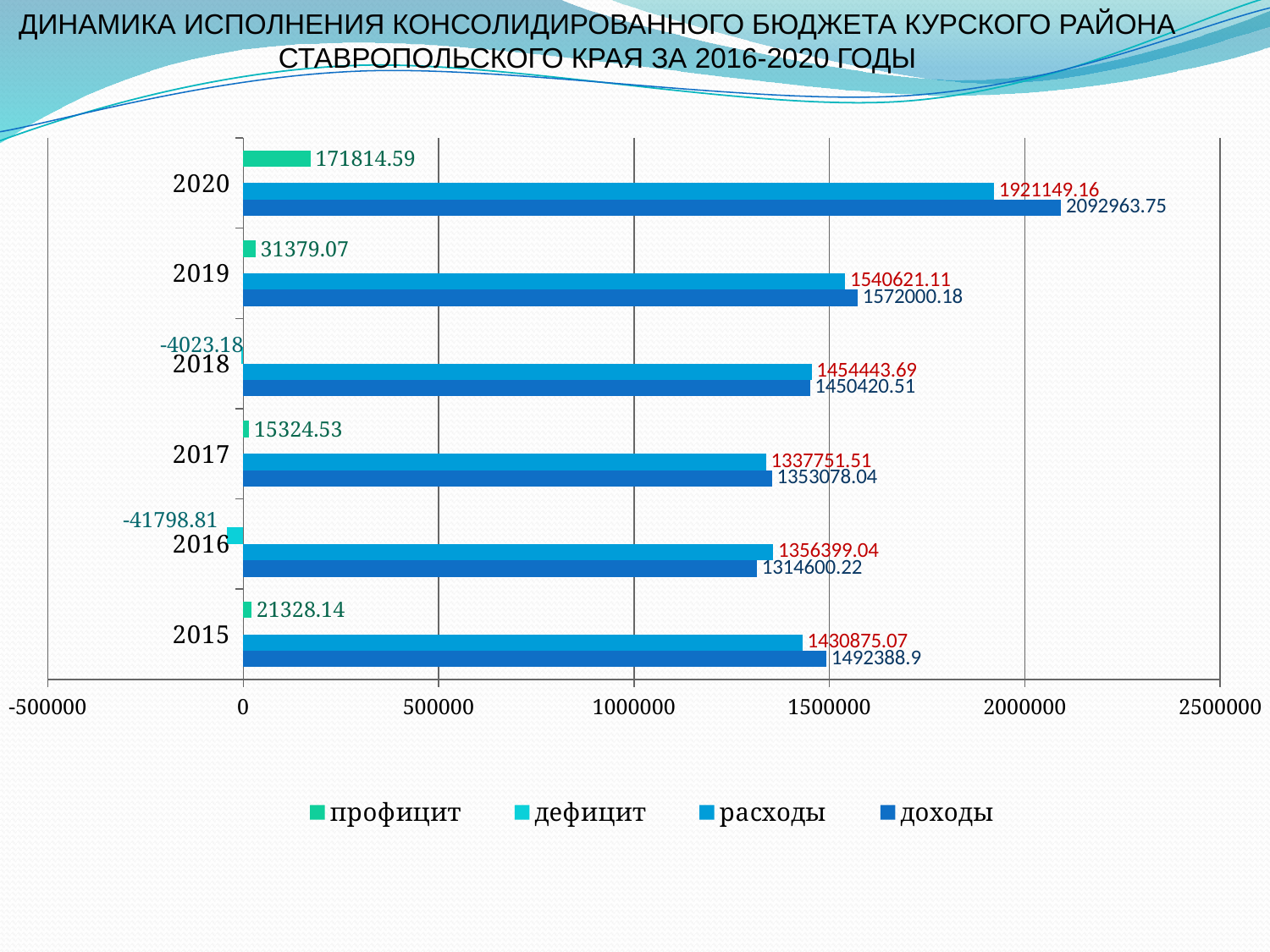
What is the value of доходы for 2020? 2092963.75 In 2016, which is larger: расходы or доходы? расходы Which year has the lowest доходы? 2016 Which year has the largest профицит? 2020 Which year has the highest доходы? 2020 What is the value of расходы for 2019? 1540621.11 What is the difference between доходы and расходы in 2020? 171814.59 What is the value of дефицит for 2016? -41798.81 How many series does the legend list? 4 What is the value of профицит for 2015? 21328.14 What kind of chart is shown on the slide? bar chart How many years are shown on the chart? 6